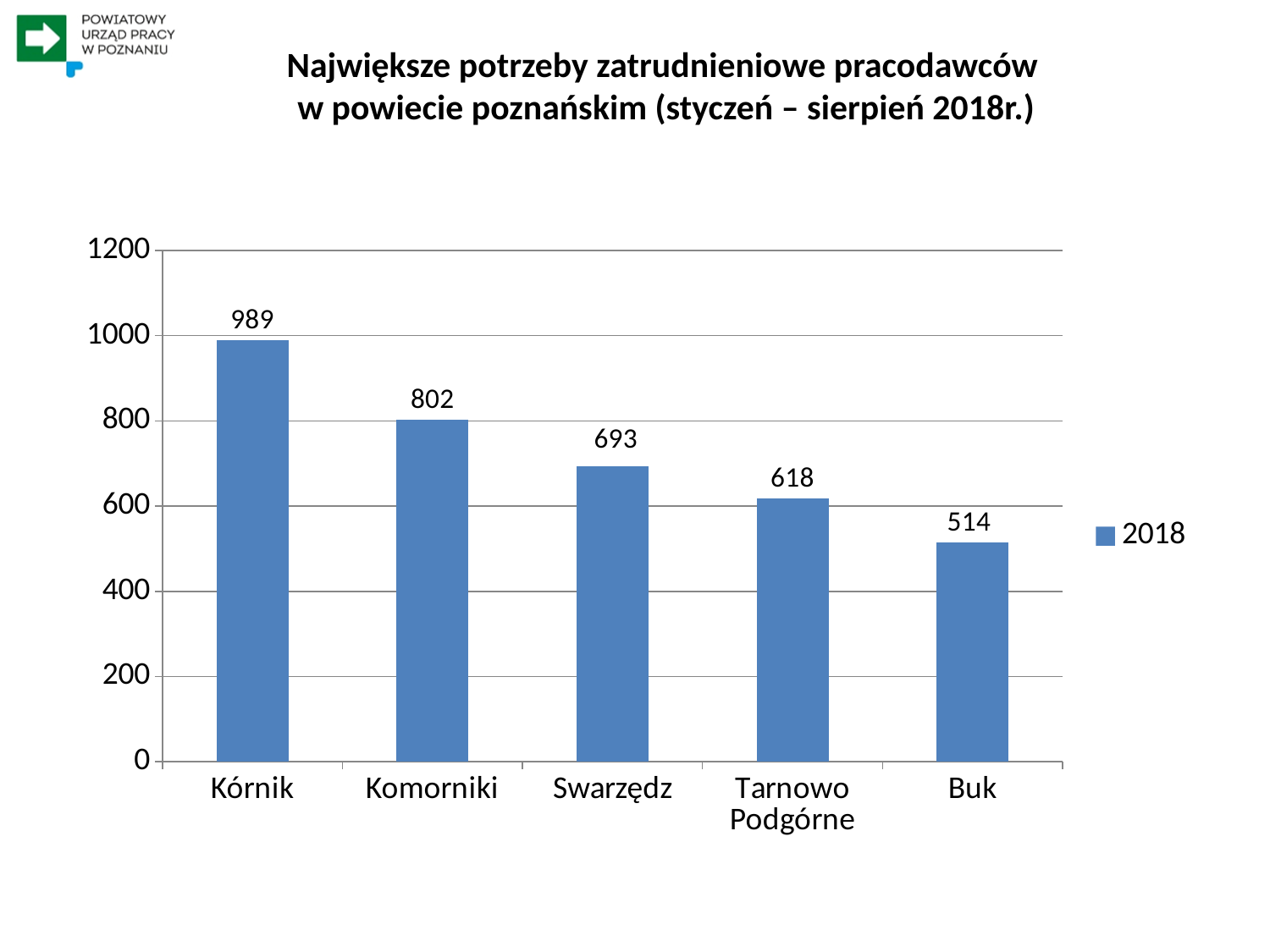
Which category has the highest value? Kórnik What kind of chart is shown on the slide? bar chart Which category has the lowest value? Buk How many series does the legend list? 1 What is the difference between the values for Swarzędz and Buk? 179 What is the value for Buk? 514 How many categories are shown on the x axis? 5 What is the difference between the values for Kórnik and Komorniki? 187 Which is larger, the value for Komorniki or the value for Swarzędz? Komorniki Do the values rise or fall from left to right along the x axis? fall What is the value for Tarnowo Podgórne? 618 What is the value for Kórnik? 989